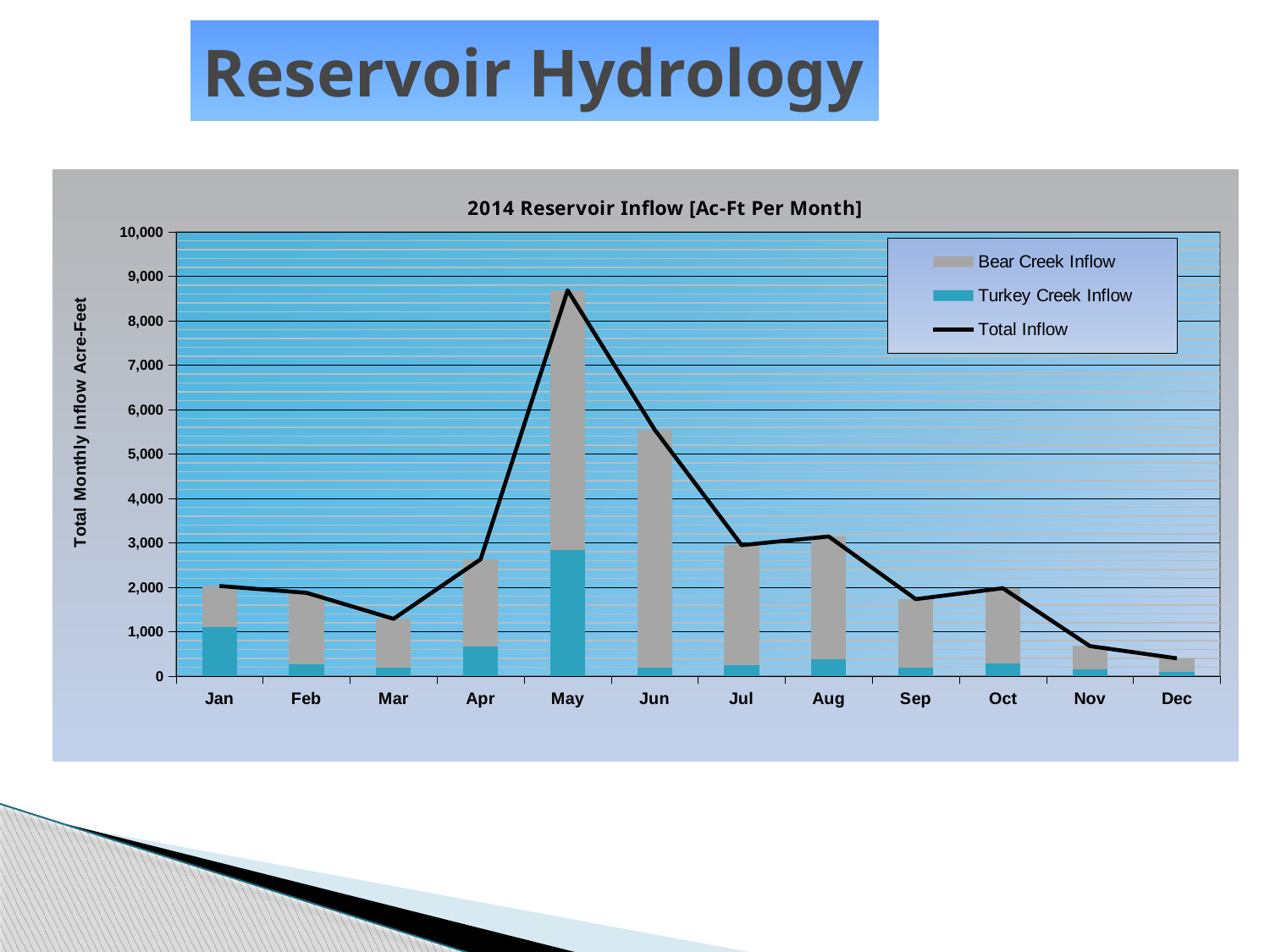
In which month is the Turkey Creek Inflow highest? May Is the Total Inflow for Mar greater or less than 2,000? less How many series does the legend list? 3 How many months are shown on the x axis? 12 Is the Total Inflow for Jun greater or less than 5,000? greater Is the Total Inflow for Dec greater or less than 1,000? less Which month has the lowest Total Inflow? Dec Does the Total Inflow rise or fall from May to Dec? fall What is the title of the chart? 2014 Reservoir Inflow [Ac-Ft Per Month] Which month has the highest Total Inflow? May Which is larger, the Total Inflow for Jun or for Jul? Jun